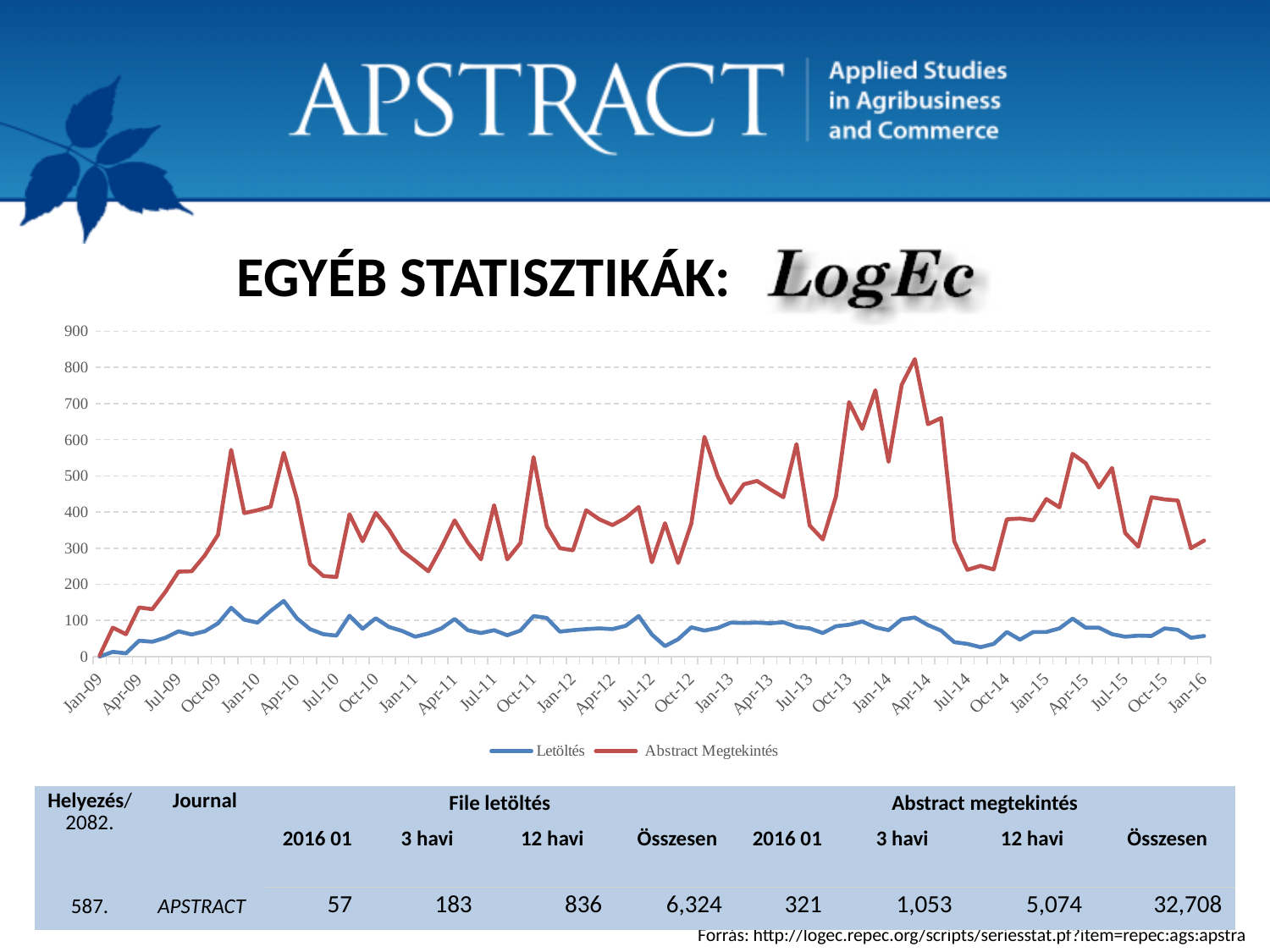
Is the highest value of the Abstract Megtekintés series greater or less than 700? greater Which series has the lower values across the chart, Letöltés or Abstract Megtekintés? Letöltés Is the Letöltés value at Jan-16 greater or less than 100? less Which series reaches the highest value on the chart, Letöltés or Abstract Megtekintés? Abstract Megtekintés Is the highest value of the Letöltés series greater or less than 200? less How many series does the chart's legend list? 2 At Jan-14, which series has the larger value, Letöltés or Abstract Megtekintés? Abstract Megtekintés What colour is the Letöltés line in the chart? blue What are the two series named in the chart's legend? Letöltés and Abstract Megtekintés What kind of chart is shown on the slide? line chart Does the Abstract Megtekintés series rise or fall between Apr-14 and Jul-14? fall